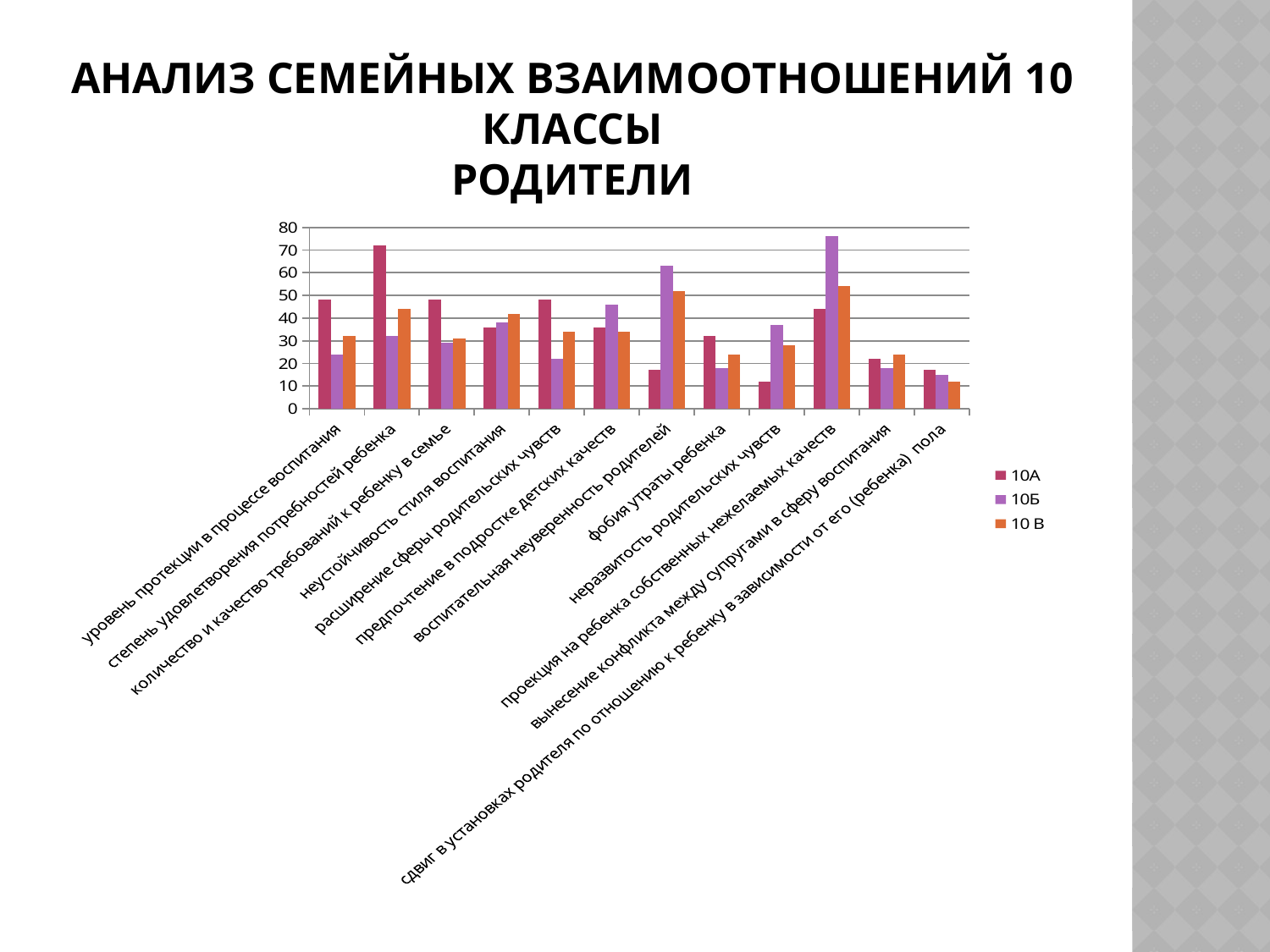
For which category is the 10А value highest? степень удовлетворения потребностей ребенка How many categories are shown along the x axis? 12 For 'воспитательная неуверенность родителей', which series has the larger value, 10А or 10 В? 10 В For which category is the 10Б value highest? проекция на ребенка собственных нежелаемых качеств How many series does the legend list? 3 Is the 10Б value for 'воспитательная неуверенность родителей' greater or less than 60? greater For 'уровень протекции в процессе воспитания', which series has the larger value, 10А or 10Б? 10А For which category is the 10 В value lowest? сдвиг в установках родителя по отношению к ребенку в зависимости от его (ребенка) пола Which series are listed in the legend? 10А, 10Б, 10 В What kind of chart is shown on the slide? bar chart Is the 10А value for 'степень удовлетворения потребностей ребенка' greater or less than 70? greater Is the 10А value for 'неразвитость родительских чувств' greater or less than 20? less